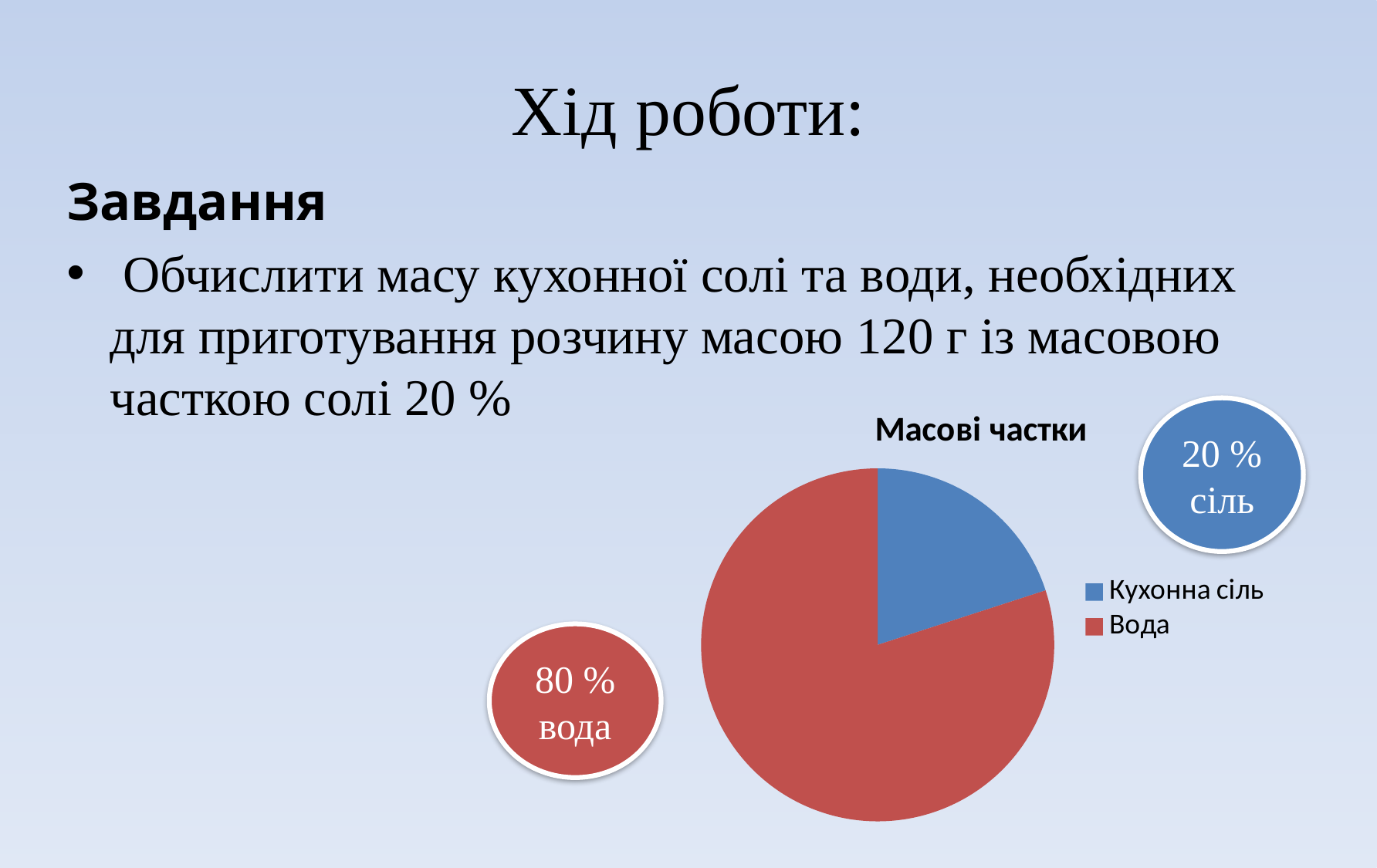
Is the share for Кухонна сіль greater or less than 50%? less How many slices does the pie chart have? 2 What is the difference between the share of Вода and the share of Кухонна сіль? 60 % What kind of chart is shown on the slide? pie chart Which is larger in the pie chart, Кухонна сіль or Вода? Вода What colour is the Вода slice in the pie chart? red What share of the pie does Вода take, as labelled on the slide? 80 % What is the title of the chart? Масові частки How many entries does the chart legend list? 2 What share of the pie does Кухонна сіль take, as labelled on the slide? 20 % Which slice of the pie chart is the largest? Вода Which slice of the pie chart is the smallest? Кухонна сіль